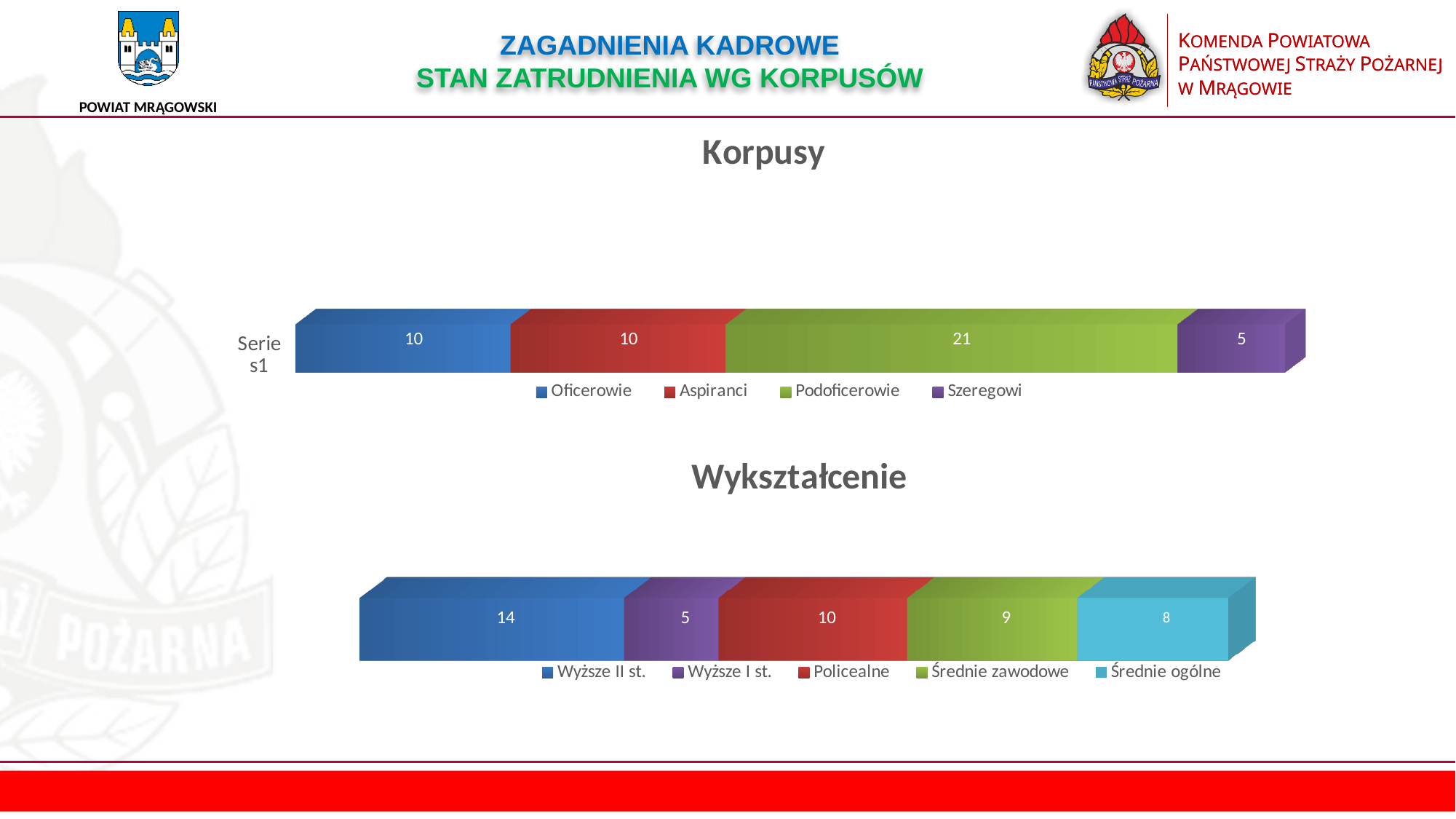
In the 'Wykształcenie' chart, what is the value for Wyższe II st.? 14 In the 'Wykształcenie' chart, what is the value for Średnie ogólne? 8 What type of chart is the 'Wykształcenie' chart? Stacked bar chart In the 'Korpusy' chart, what is the value for Szeregowi? 5 In the 'Korpusy' chart, how many series does the legend list? 4 In the 'Korpusy' chart, which series has the highest value? Podoficerowie In the 'Wykształcenie' chart, what is the difference between Wyższe II st. and Policealne? 4 In the 'Wykształcenie' chart, what is the total of the stacked bar? 46 In the 'Korpusy' chart, what is the total of the stacked bar? 46 In the 'Wykształcenie' chart, which is larger, Średnie zawodowe or Wyższe I st.? Średnie zawodowe In the 'Korpusy' chart, which series has the lowest value? Szeregowi In the 'Korpusy' chart, what is the value for Podoficerowie? 21